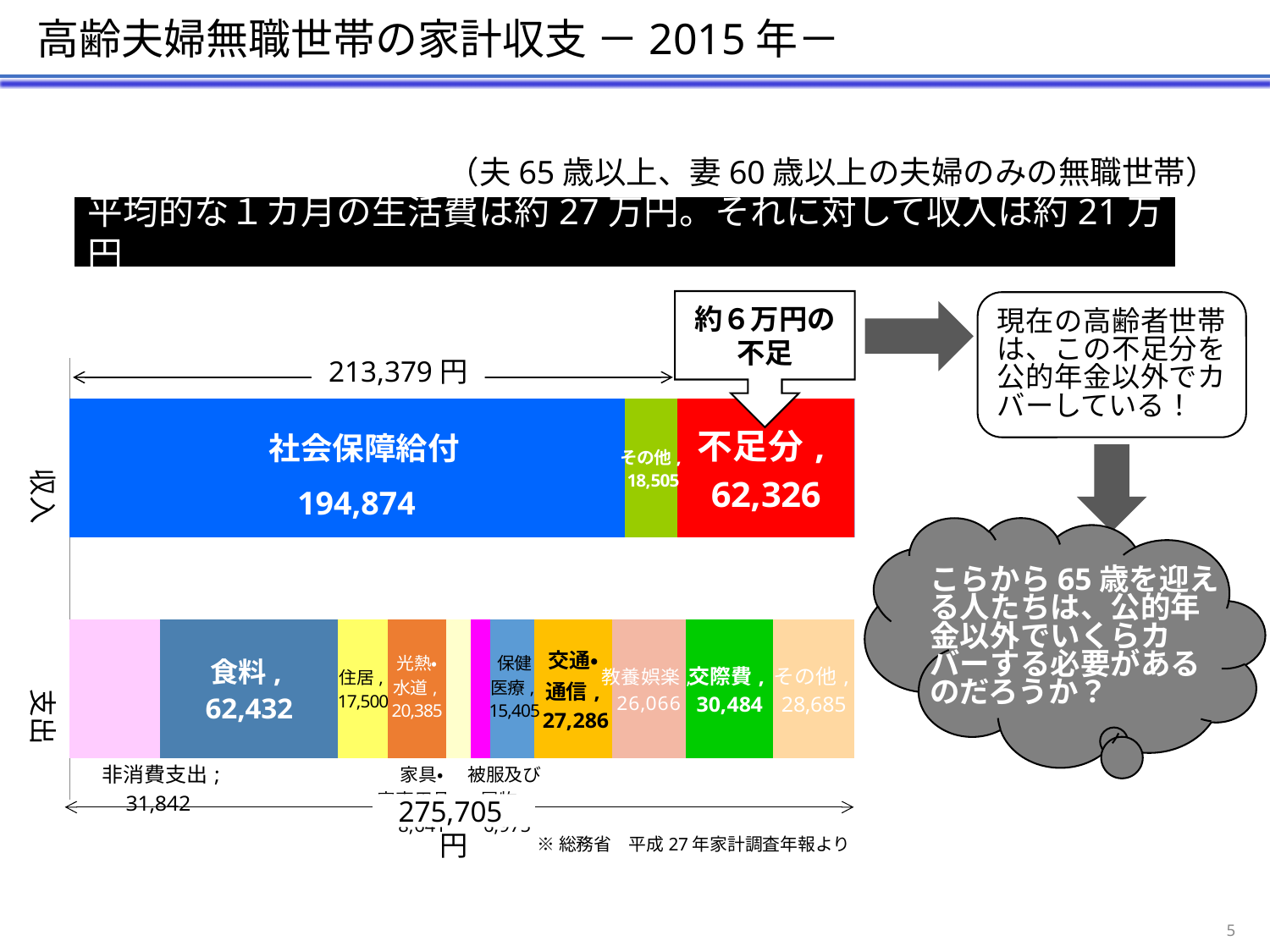
In the 収入 bar, what is the value for 不足分? 62,326 What total is shown for the 支出 bar? 275,705 円 In the 支出 bar, what is the value for 食料? 62,432 In the 支出 bar, what is the value for 交通・通信? 27,286 What type of chart is shown on the slide? stacked bar chart Which is larger in the 支出 bar: 教養娯楽 or 保健医療? 教養娯楽 What is the difference between 食料 (62,432) and 住居 (17,500) in the 支出 bar? 44,932 In the 収入 bar, what is the value for その他? 18,505 In the 支出 bar, what is the value for 非消費支出? 31,842 Which segment of the 支出 bar is the largest? 食料 In the 収入 bar, what is the value for 社会保障給付? 194,874 In the 支出 bar, what is the value for 交際費? 30,484